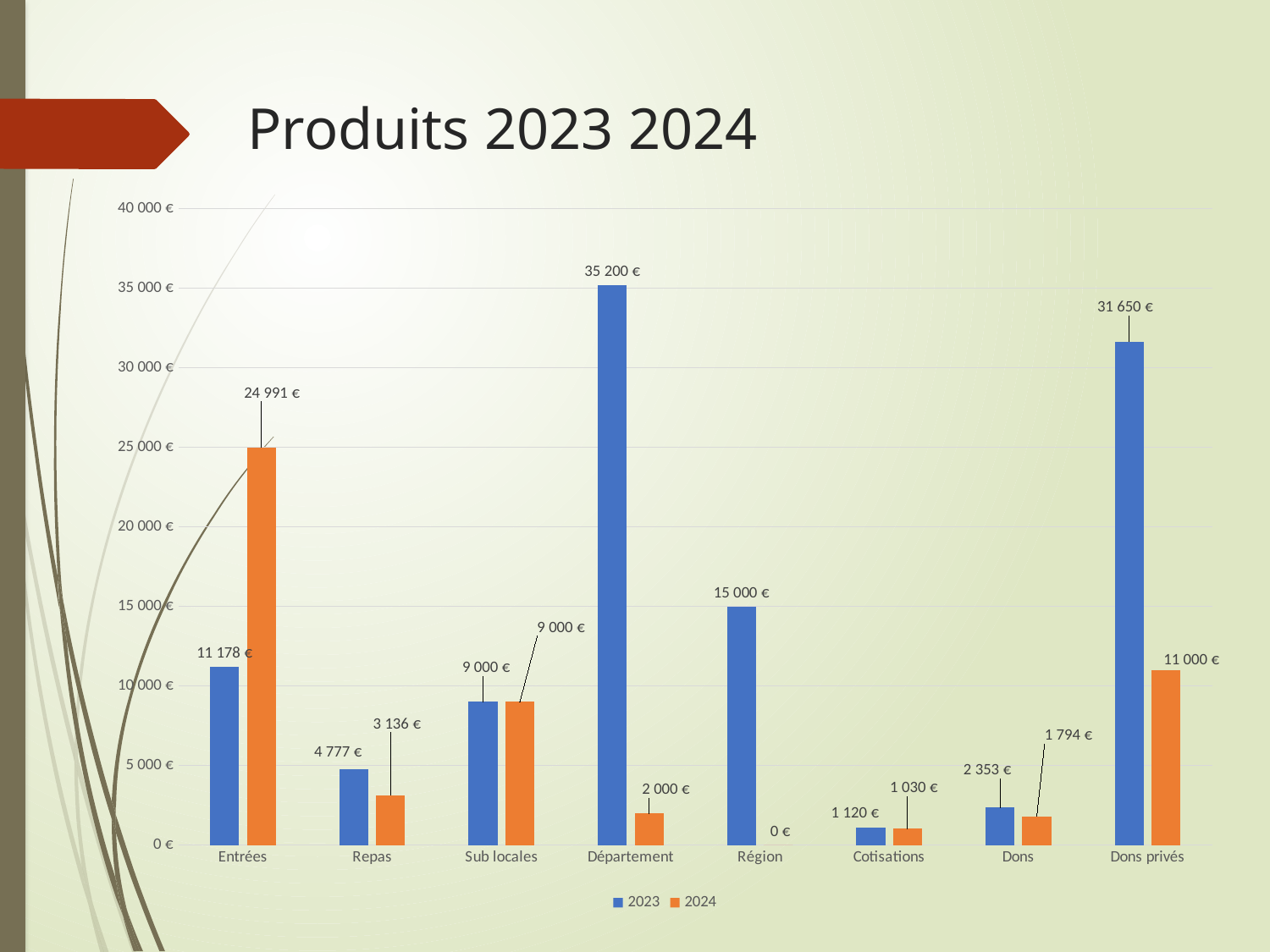
Which category has the lowest 2024 value? Région What is the difference between the 2024 and 2023 values for Entrées? 13 813 € What type of chart is shown on the slide? Bar chart Which is larger for Repas, the 2023 value or the 2024 value? 2023 How many series does the legend list? 2 What is the 2024 value for Région? 0 € What is the 2024 value for Entrées? 24 991 € Which category has the highest 2023 value? Département What is the 2023 value for Département? 35 200 € How many categories are shown on the x axis? 8 What is the title of the chart? Produits 2023 2024 What is the difference between the 2023 and 2024 values for Dons privés? 20 650 €